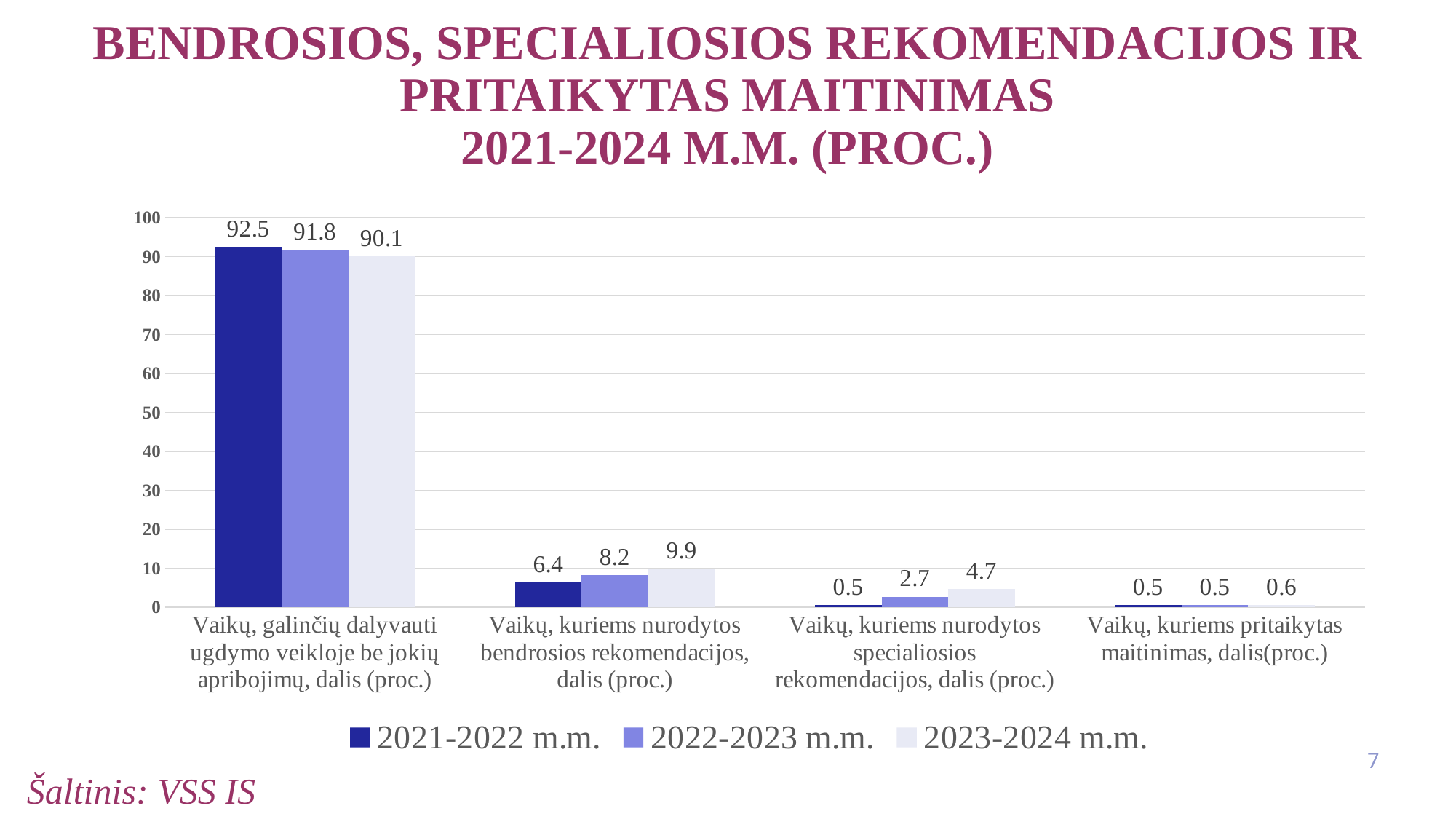
What is the difference between the 2021-2022 m.m. and 2023-2024 m.m. values in the category "Vaikų, galinčių dalyvauti ugdymo veikloje be jokių apribojimų, dalis (proc.)"? 2.4 What source is cited at the bottom of the slide? VSS IS What is the value for 2023-2024 m.m. in the category "Vaikų, kuriems pritaikytas maitinimas, dalis(proc.)"? 0.6 Which series has the lowest value in the category "Vaikų, galinčių dalyvauti ugdymo veikloje be jokių apribojimų, dalis (proc.)"? 2023-2024 m.m. How many categories are shown on the x axis? 4 What is the value for 2023-2024 m.m. in the category "Vaikų, kuriems nurodytos bendrosios rekomendacijos, dalis (proc.)"? 9.9 Which series has the highest value in the category "Vaikų, kuriems nurodytos bendrosios rekomendacijos, dalis (proc.)"? 2023-2024 m.m. What is the value for 2022-2023 m.m. in the category "Vaikų, kuriems nurodytos specialiosios rekomendacijos, dalis (proc.)"? 2.7 Does the 2021-2022 m.m. value for "Vaikų, kuriems nurodytos bendrosios rekomendacijos, dalis (proc.)" rise or fall across the three school years? rise What is the value for 2021-2022 m.m. in the category "Vaikų, galinčių dalyvauti ugdymo veikloje be jokių apribojimų, dalis (proc.)"? 92.5 How many series does the legend list? 3 What type of chart is shown on the slide? bar chart